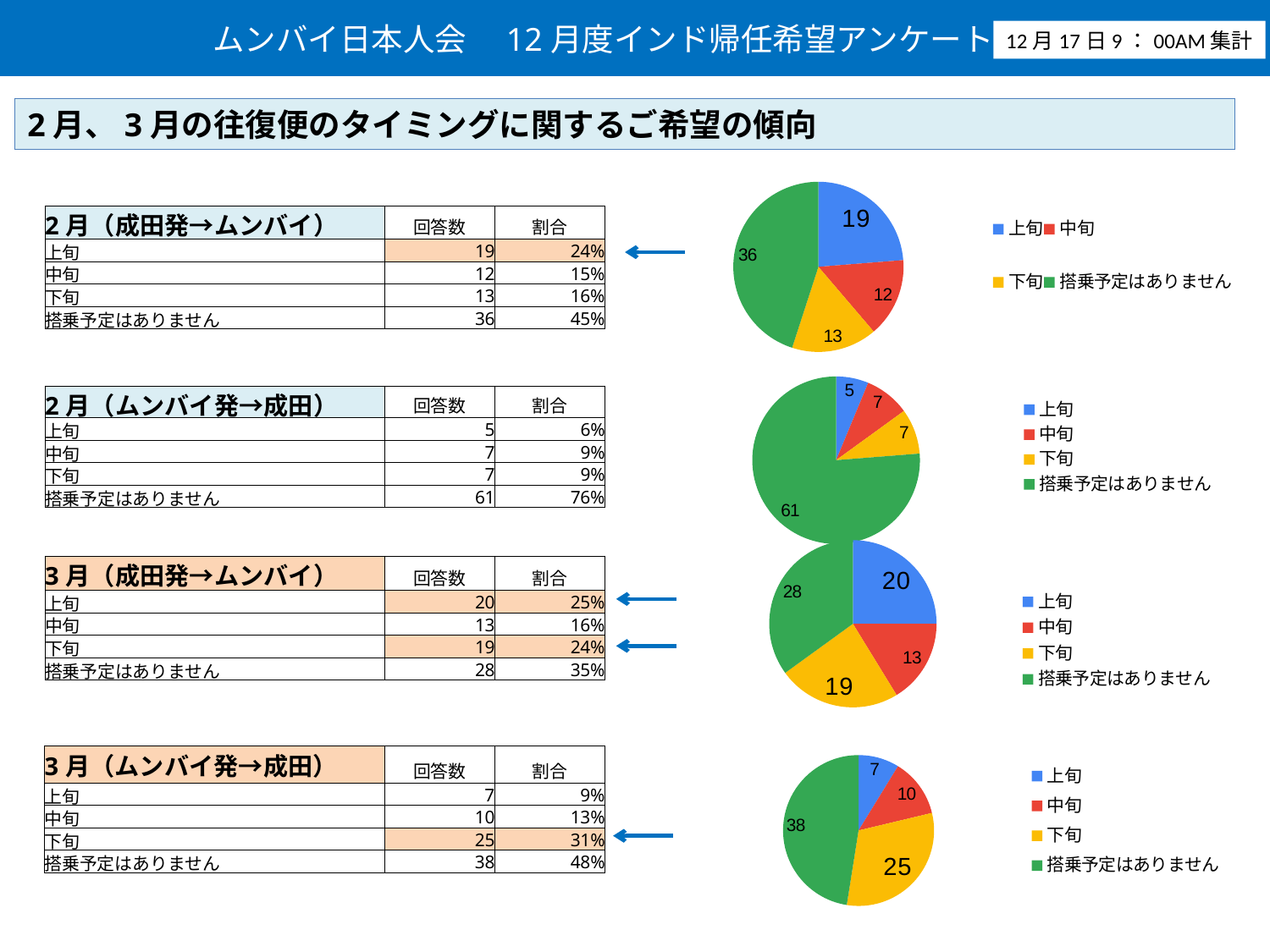
How many slices does the top pie chart (2月 成田発→ムンバイ) have? 4 In the second pie chart from the top (2月 ムンバイ発→成田), which category has the smallest slice? 上旬 In the second pie chart from the top (2月 ムンバイ発→成田), which category has the largest slice? 搭乗予定はありません In the third pie chart from the top (3月 成田発→ムンバイ), what is the value for 下旬? 19 What colour is the 下旬 slice in the pie charts? Yellow In the bottom pie chart (3月 ムンバイ発→成田), which is larger, 下旬 or 中旬? 下旬 In the top pie chart (2月 成田発→ムンバイ), what share of the total does 搭乗予定はありません represent? 45% In the top pie chart (2月 成田発→ムンバイ), what is the value for 搭乗予定はありません? 36 In the bottom pie chart (3月 ムンバイ発→成田), what is the value for 搭乗予定はありません? 38 What kind of charts are shown on the slide? Pie charts In the top pie chart (2月 成田発→ムンバイ), what is the value for 上旬? 19 In the third pie chart from the top (3月 成田発→ムンバイ), what is the difference between 搭乗予定はありません and 上旬? 8